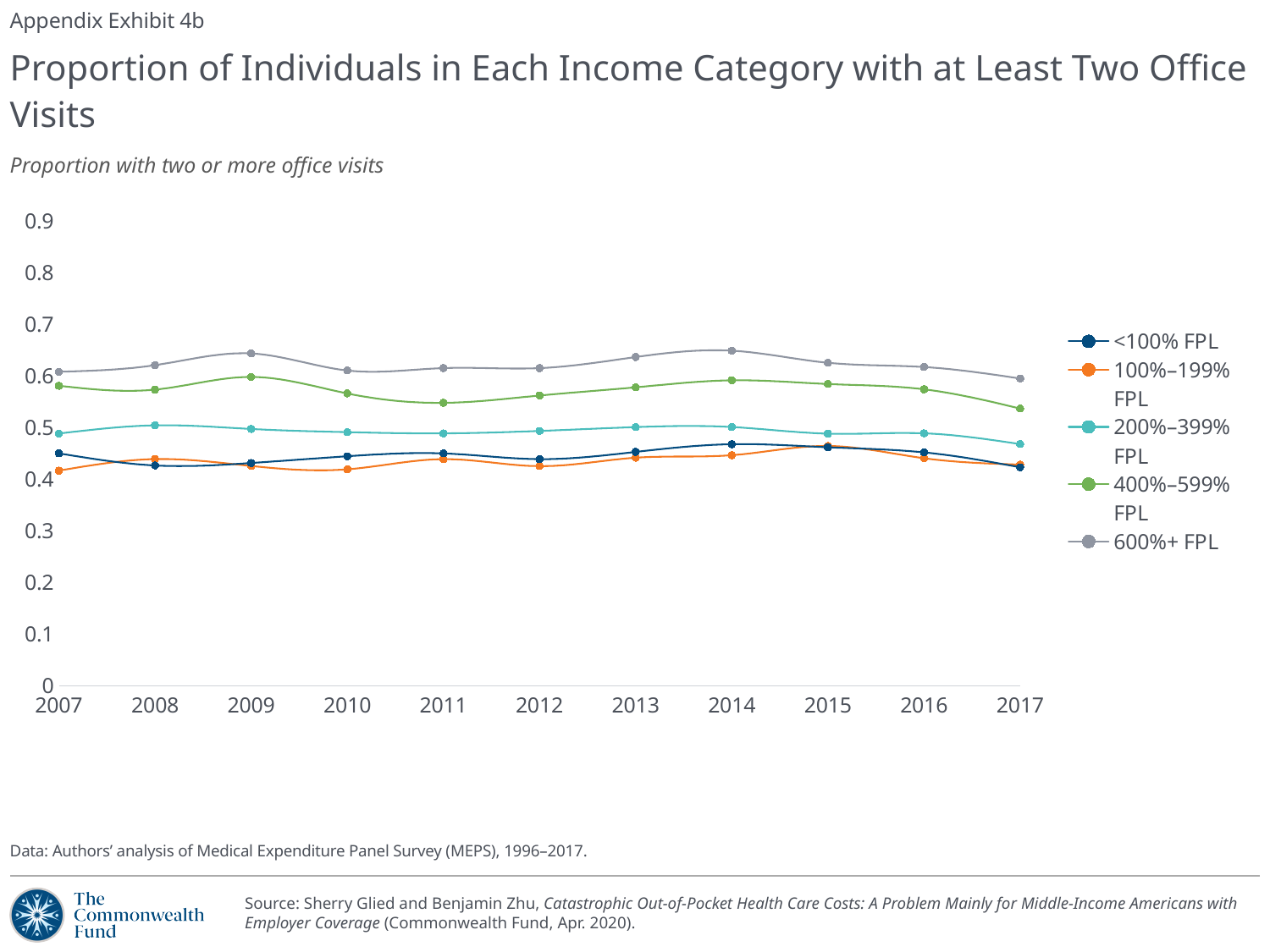
Is the value for 600%+ FPL in 2014 greater or less than 0.6? greater How many series does the legend list? 5 Is the value for <100% FPL in 2007 greater or less than 0.5? less Which income category has the highest proportion in 2014? 600%+ FPL Is the value for 400%–599% FPL in 2011 greater or less than 0.6? less How many years are plotted along the x axis? 11 What kind of chart is shown on the slide? line chart In 2009, which is larger: the value for 400%–599% FPL or the value for 200%–399% FPL? 400%–599% FPL Does the value for 400%–599% FPL rise or fall from 2014 to 2017? fall Which income category is represented by the orange line? 100%–199% FPL